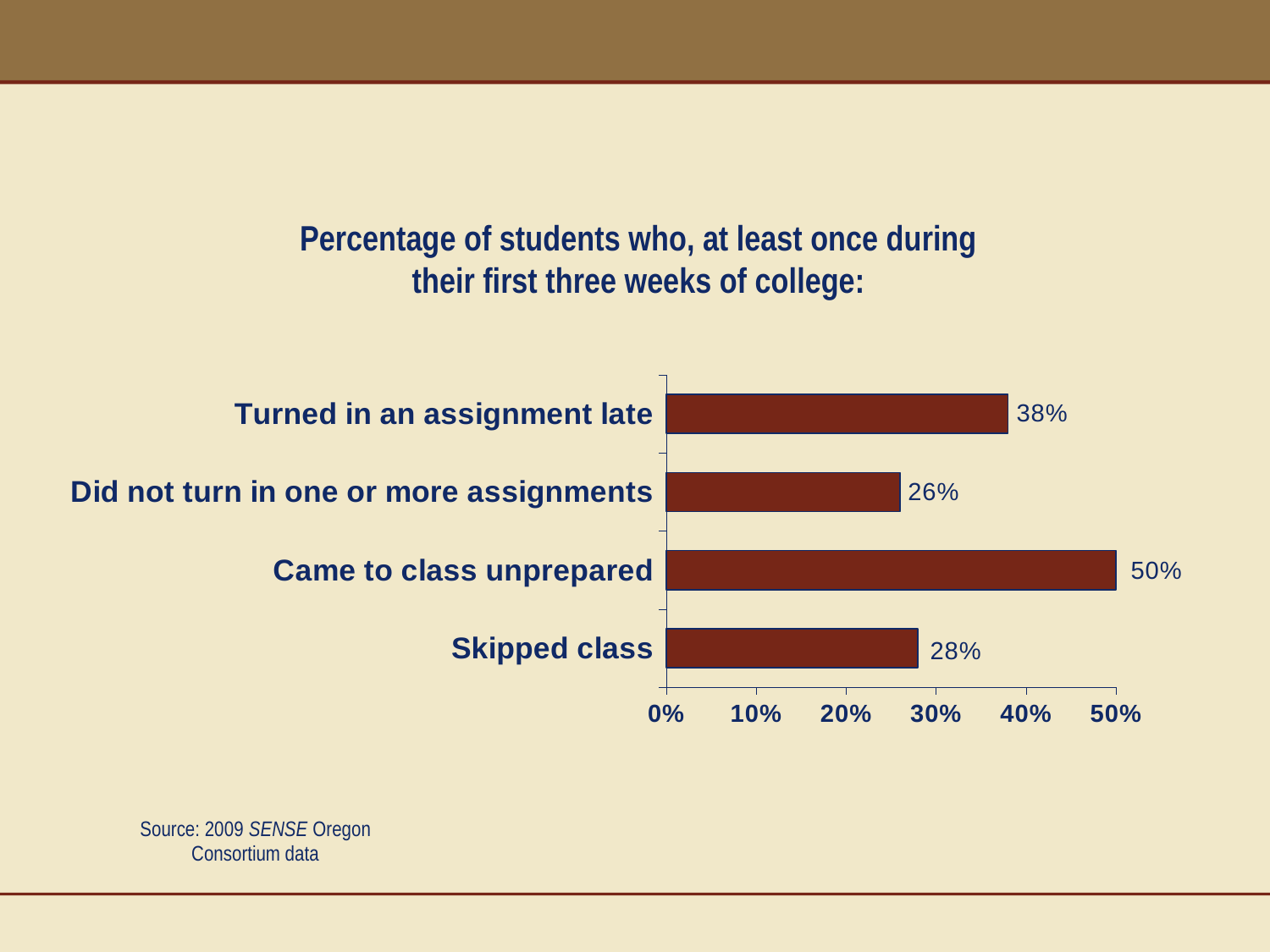
Which category has the lowest percentage? Did not turn in one or more assignments Which is larger: the percentage who turned in an assignment late or the percentage who skipped class? Turned in an assignment late Which category has the highest percentage? Came to class unprepared How many categories are shown in the chart? 4 What is the difference between the percentage who came to class unprepared and the percentage who skipped class? 22% What kind of chart is shown on the slide? Bar chart What percentage of students turned in an assignment late? 38% What percentage of students came to class unprepared? 50% What percentage of students did not turn in one or more assignments? 26% Is the value for 'Turned in an assignment late' greater or less than 30%? greater What is the source cited for the chart data? 2009 SENSE Oregon Consortium data What percentage of students skipped class? 28%